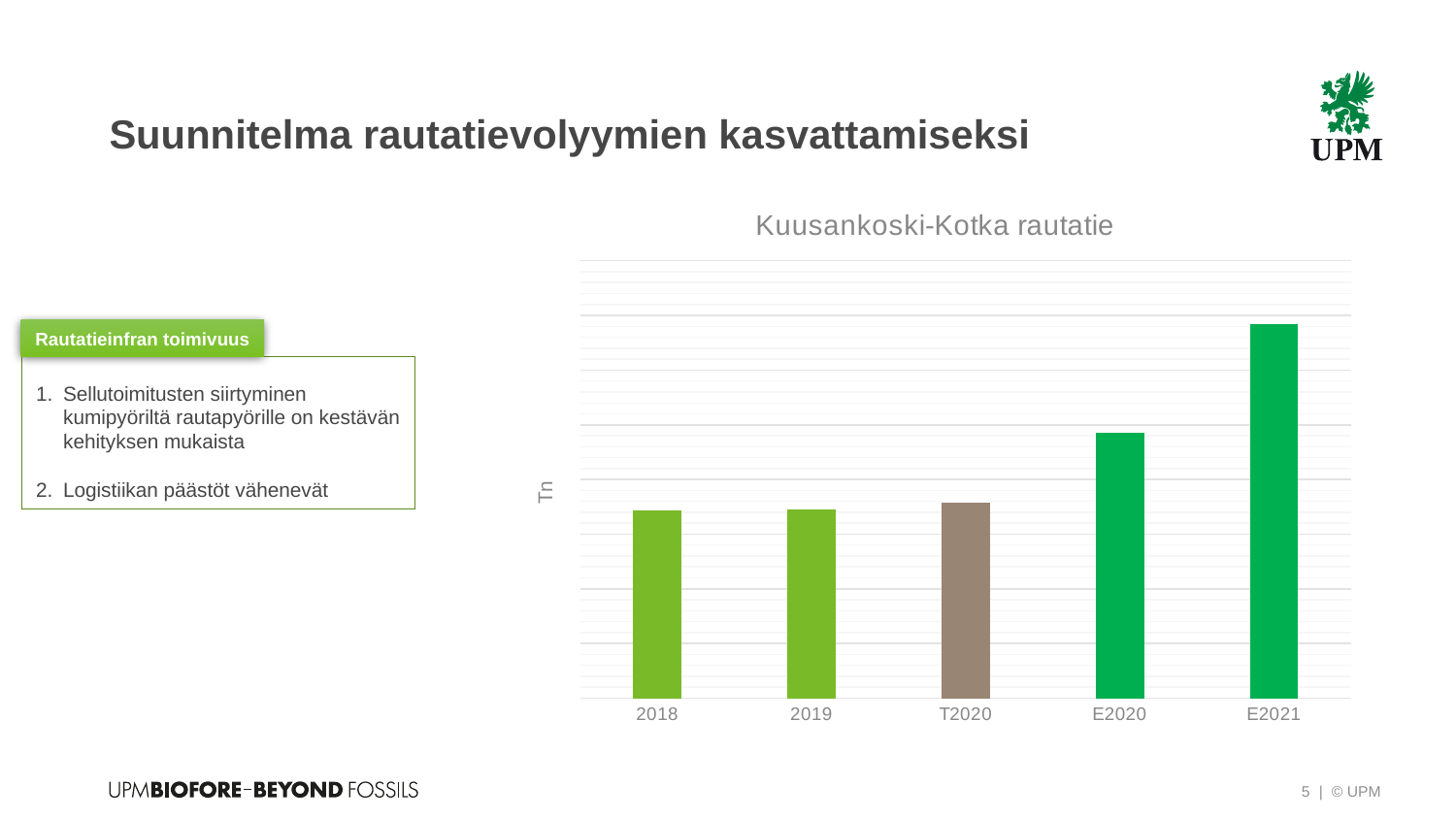
Do the values generally rise or fall from 2018 to E2021? rise Which is larger, the value for 2018 or the value for E2020? E2020 Which is larger, the value for T2020 or the value for E2020? E2020 How many categories are shown on the x axis of the chart? 5 What label is shown on the y axis of the chart? Tn Which is larger, the value for E2020 or the value for E2021? E2021 What type of chart is shown on the slide? bar chart What is the title of the chart? Kuusankoski-Kotka rautatie Which category has the highest bar in the chart? E2021